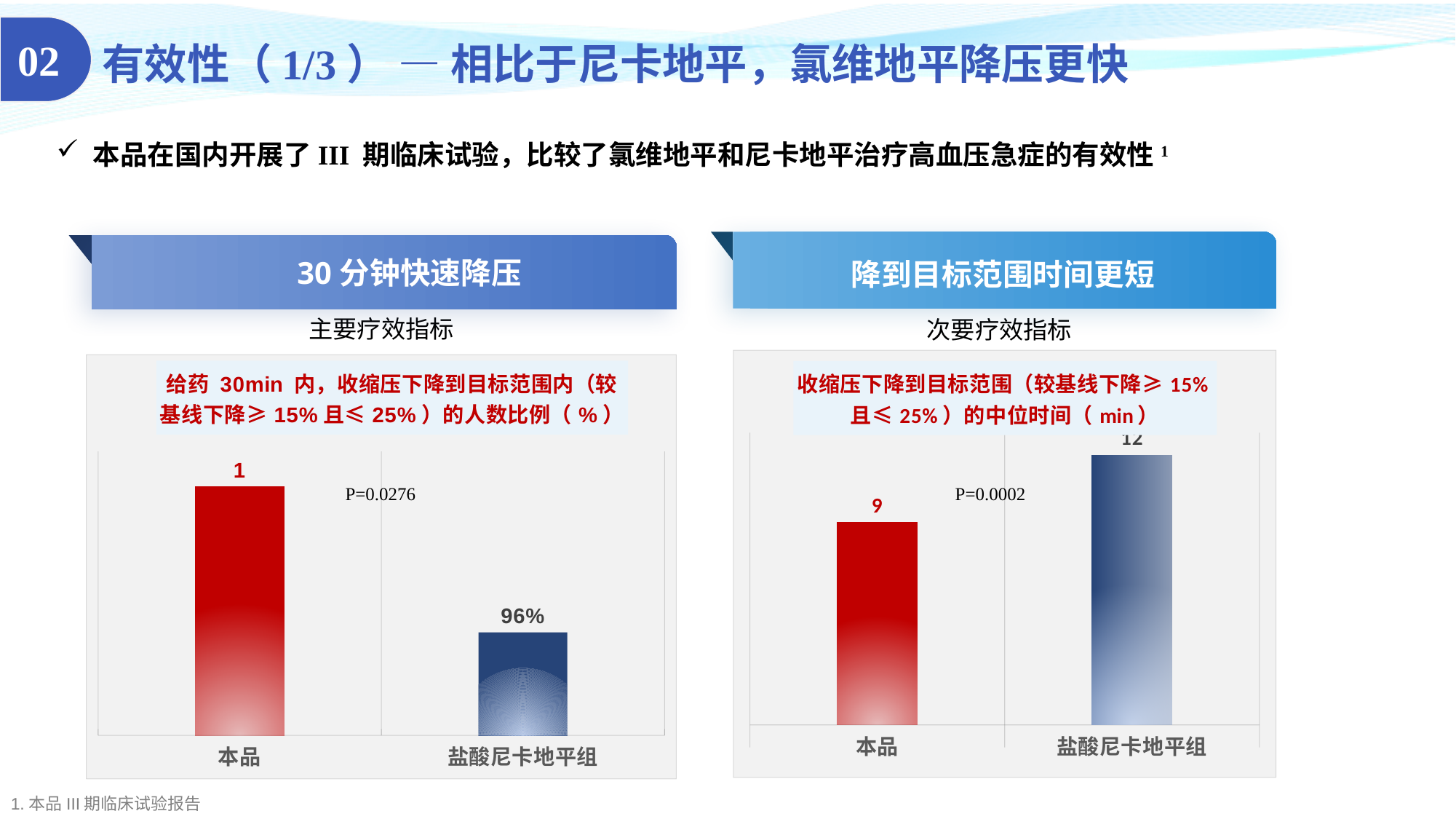
What P value is printed on the left chart (主要疗效指标)? P=0.0276 In the left chart (主要疗效指标), how many groups are plotted? 2 In the right chart (次要疗效指标), what is the median time shown for 盐酸尼卡地平组? 12 In the right chart (次要疗效指标), what is the difference between the values for 盐酸尼卡地平组 and 本品? 3 In the right chart (次要疗效指标), which group has the lowest value? 本品 In the left chart (主要疗效指标), what value is shown for 盐酸尼卡地平组? 96% In the right chart (次要疗效指标), how many bars are plotted? 2 What kind of chart is the left chart (主要疗效指标)? bar chart What P value is printed on the right chart (次要疗效指标)? P=0.0002 In the right chart (次要疗效指标), which group has the larger value, 本品 or 盐酸尼卡地平组? 盐酸尼卡地平组 In the left chart (主要疗效指标), which group has the taller bar? 本品 In the right chart (次要疗效指标), what is the median time shown for 本品? 9